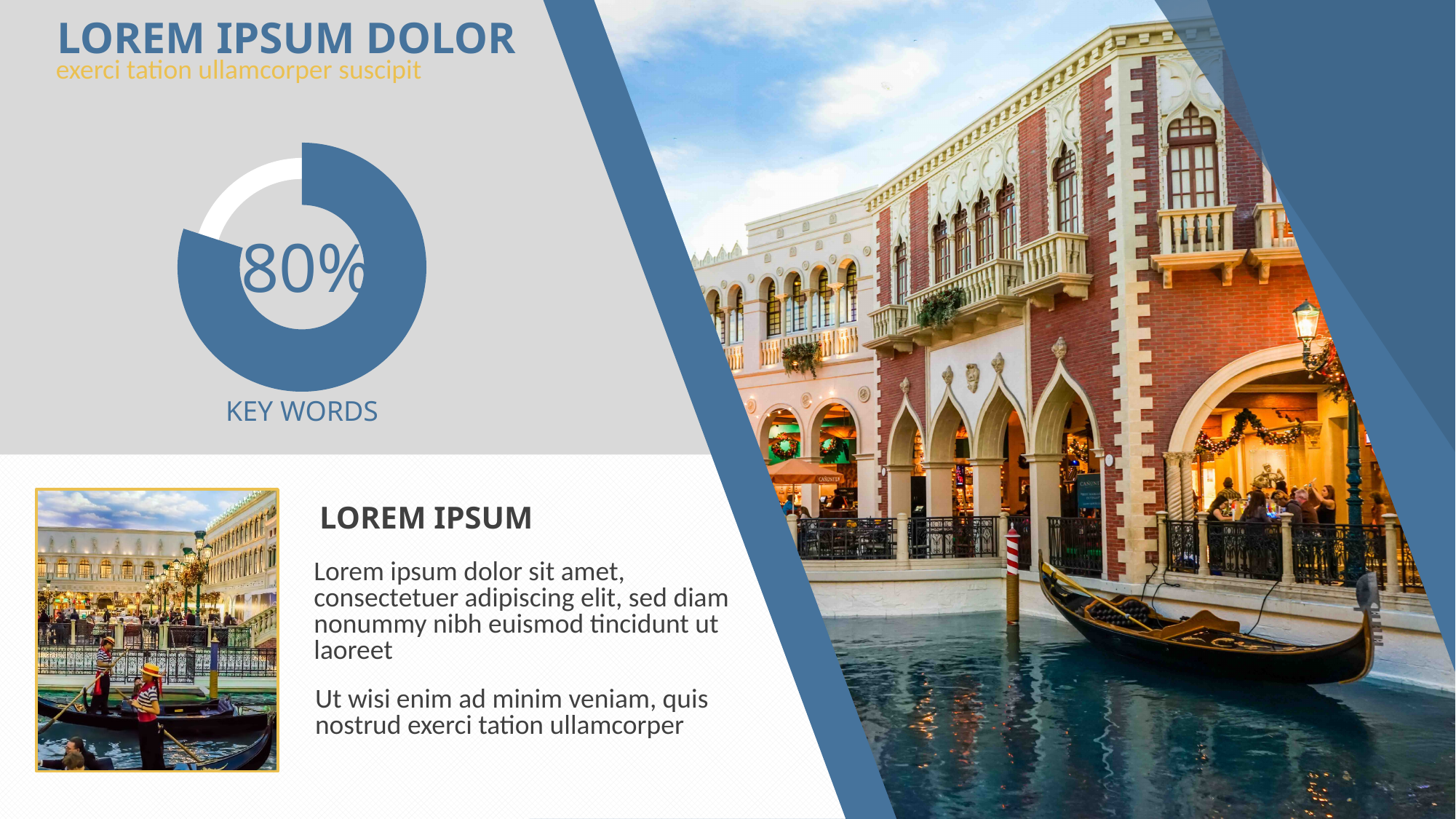
What share of the doughnut chart does the white segment represent? 20% What share of the doughnut chart does the blue segment represent? 80% What colour is the larger segment of the doughnut chart? blue How many segments does the doughnut chart have? 2 Is the white segment of the doughnut chart greater or less than 50%? less Is the blue segment of the doughnut chart greater or less than 50%? greater What kind of chart is shown on the left side of the slide? doughnut chart What label appears directly below the doughnut chart? KEY WORDS Which segment of the doughnut chart is larger, the blue one or the white one? blue What percentage value is printed in the centre of the doughnut chart? 80%